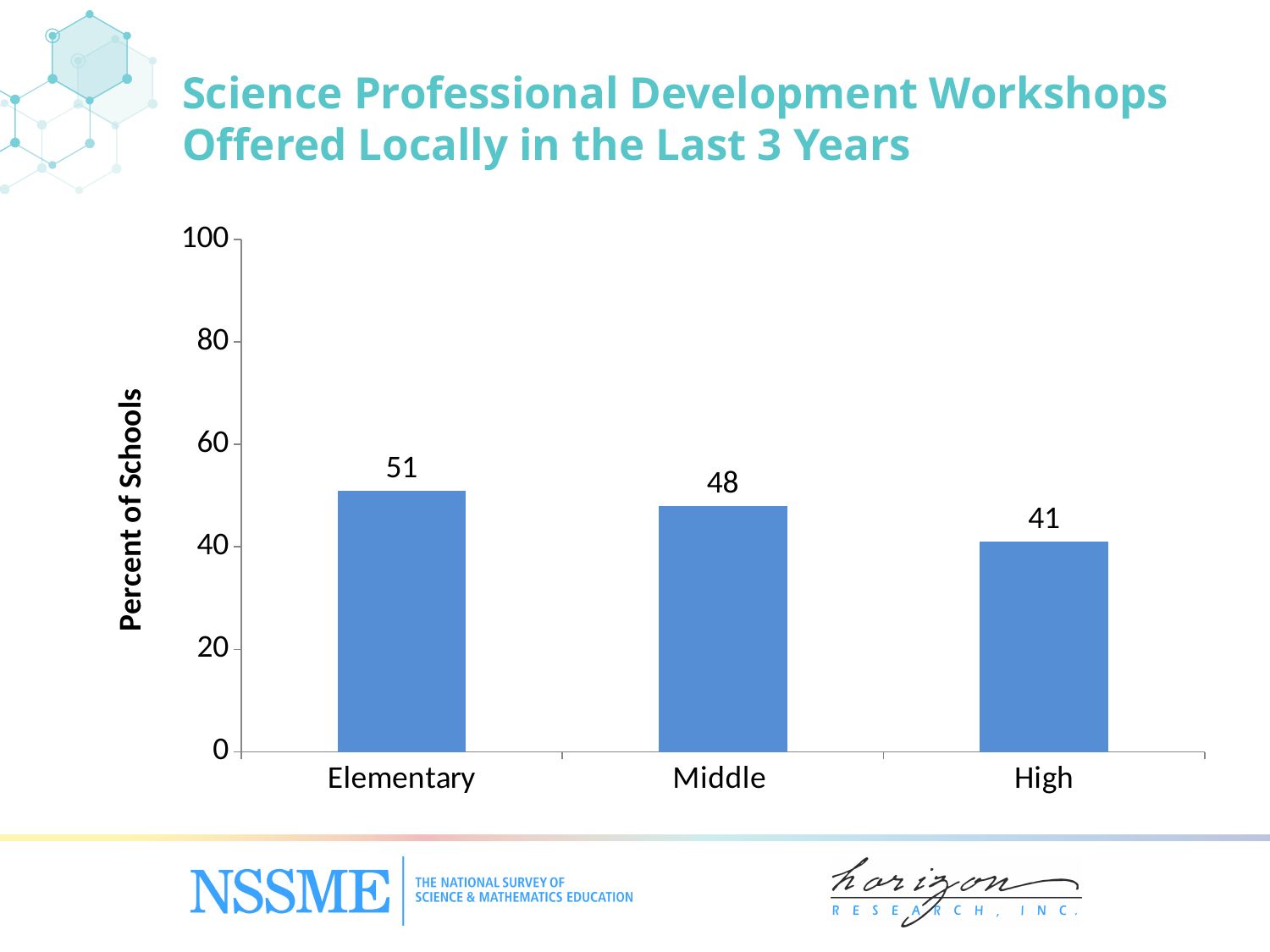
Is the value for High greater or less than 60? less Which school level has the lowest percent of schools? High What kind of chart is shown on the slide? bar chart What is the value for Elementary schools? 51 How many categories are shown on the x axis? 3 What is the difference between the values for Middle and High? 7 What is the label of the y axis? Percent of Schools Which is larger, the value for Elementary or the value for High? Elementary What is the difference between the values for Elementary and High? 10 What is the value for High schools? 41 Which school level has the highest percent of schools? Elementary What is the value for Middle schools? 48